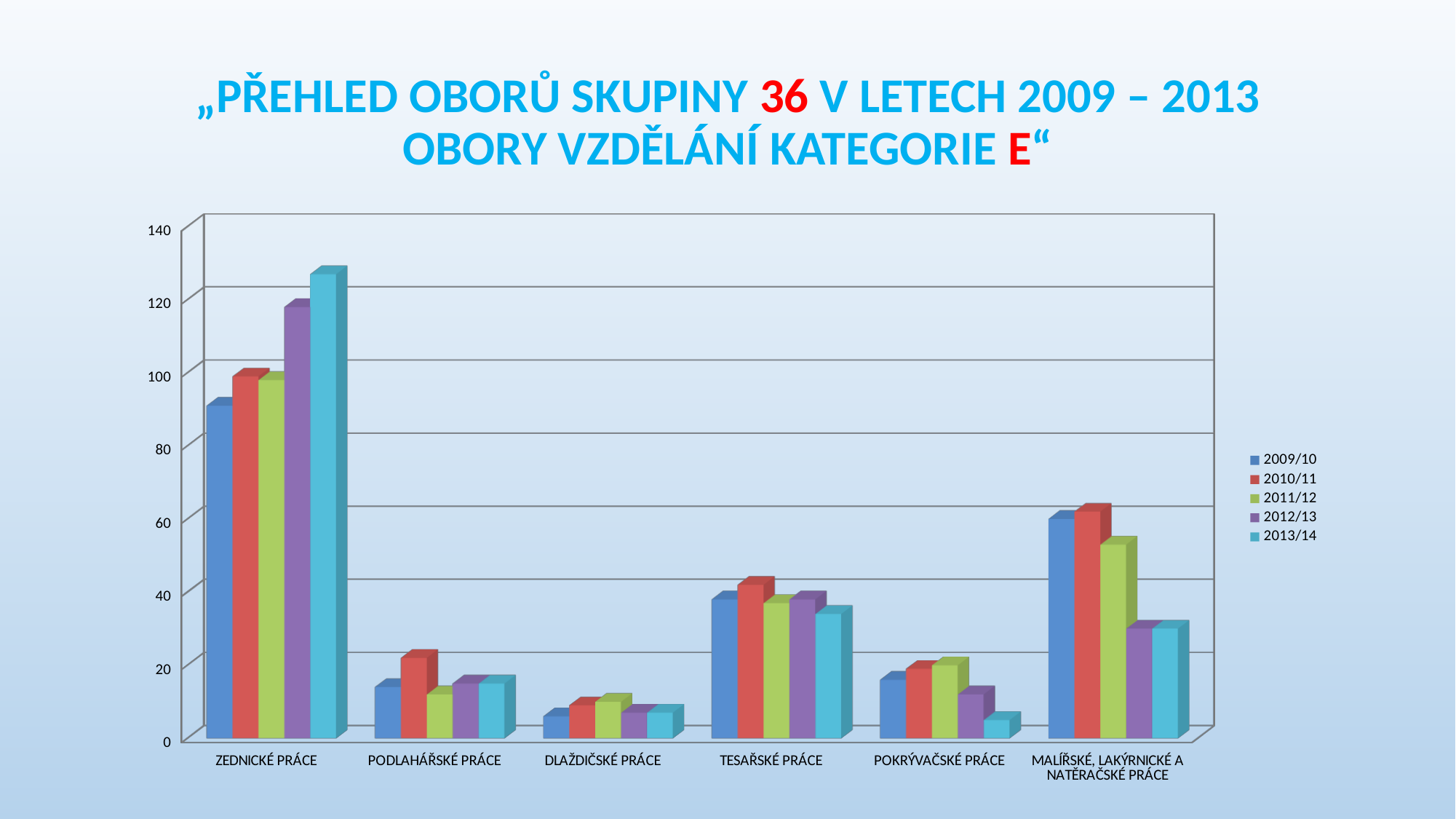
What kind of chart is shown on the slide? bar chart How many categories are shown on the x axis of the chart? 6 Is the 2009/10 value for MALÍŘSKÉ, LAKÝRNICKÉ A NATĚRAČSKÉ PRÁCE greater or less than 40? greater Which is larger: the 2013/14 value for ZEDNICKÉ PRÁCE or the 2013/14 value for MALÍŘSKÉ, LAKÝRNICKÉ A NATĚRAČSKÉ PRÁCE? ZEDNICKÉ PRÁCE Is the 2013/14 value for TESAŘSKÉ PRÁCE greater or less than 40? less Which series is listed first in the chart legend? 2009/10 Which category has the lowest value for the 2009/10 series? DLAŽDIČSKÉ PRÁCE Which category has the highest value for the 2013/14 series? ZEDNICKÉ PRÁCE Is the 2013/14 value for ZEDNICKÉ PRÁCE greater or less than 120? greater Which is larger: the 2010/11 value for PODLAHÁŘSKÉ PRÁCE or the 2010/11 value for DLAŽDIČSKÉ PRÁCE? PODLAHÁŘSKÉ PRÁCE How many series does the chart legend list? 5